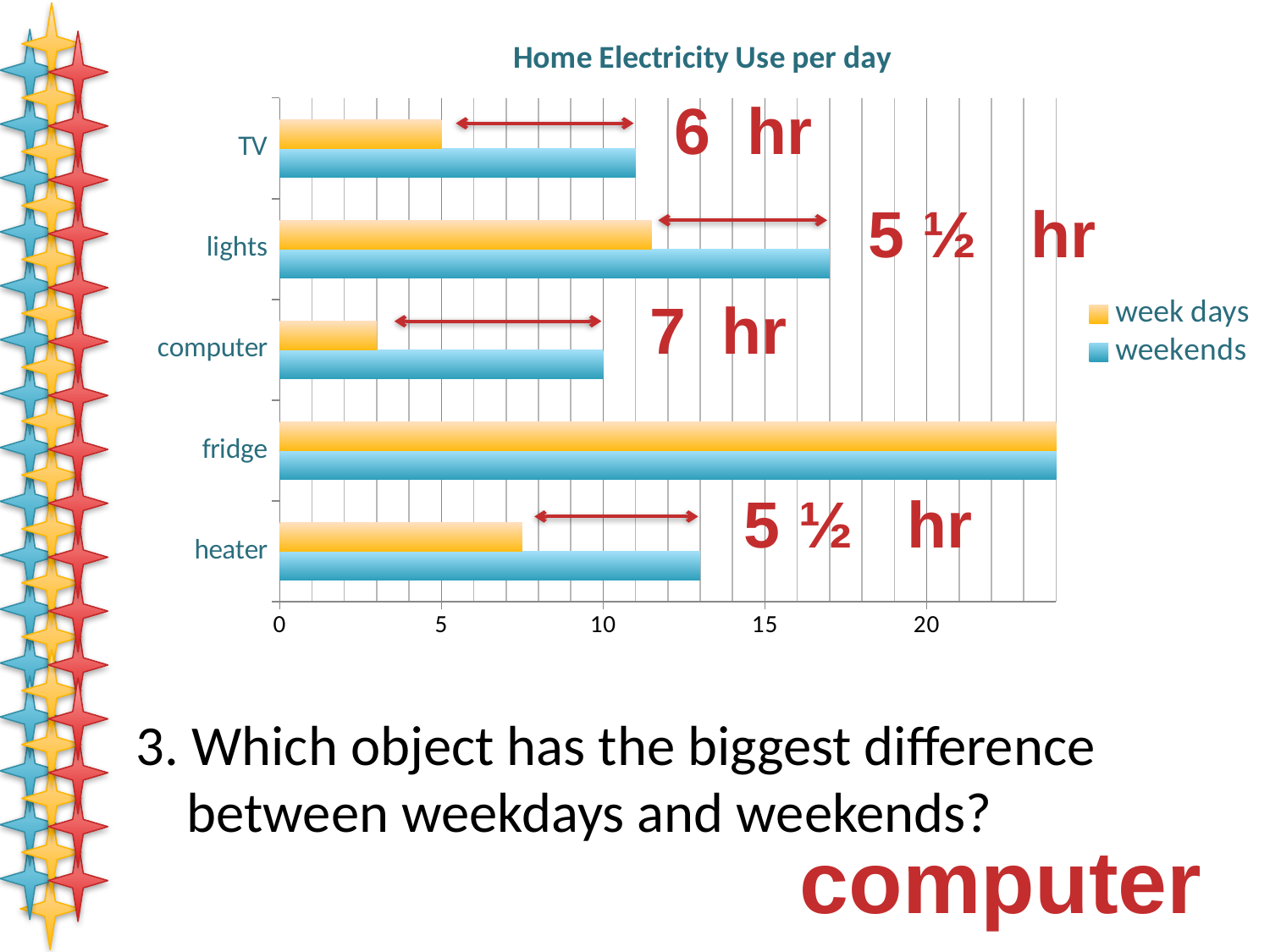
According to the annotation on the chart, what is the difference between weekdays and weekends for the computer? 7 hr What is the title of the chart? Home Electricity Use per day How many categories (objects) are shown on the chart? 5 Which object has the highest weekends value? fridge Is the weekends value for lights greater or less than 15? greater What is the week days value for TV? 5 According to the annotation on the chart, what is the difference between weekdays and weekends for the TV? 6 hr Which object has the lowest week days value? computer Which has the larger weekends value, lights or heater? lights What kind of chart is shown on the slide? bar chart How many series does the legend list? 2 What is the weekends value for computer? 10